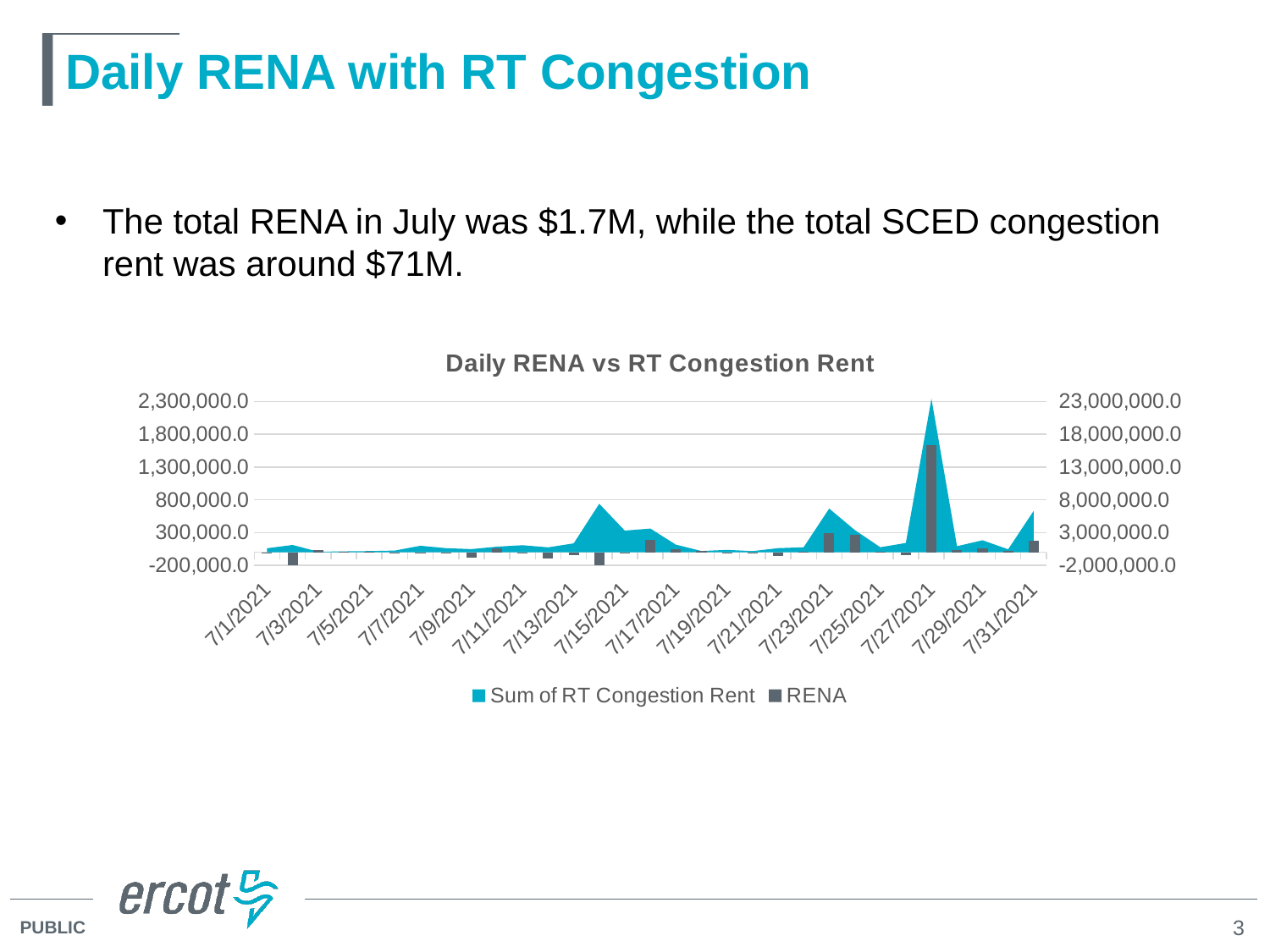
On which date is the RENA bar the tallest? 7/27/2021 Is the Sum of RT Congestion Rent on 7/19/2021 greater or less than 3,000,000.0 on the right axis? less What is the title of the chart? Daily RENA vs RT Congestion Rent Which is larger, the RENA value on 7/27/2021 or on 7/23/2021? 7/27/2021 On which date does the Sum of RT Congestion Rent reach its highest peak? 7/27/2021 Which is larger, the Sum of RT Congestion Rent on 7/27/2021 or on 7/15/2021? 7/27/2021 How many series does the legend list? 2 Which series is drawn as the teal shaded area? Sum of RT Congestion Rent What kind of chart is this? A combination chart with an area series and a bar series How many date labels are shown on the x axis? 16